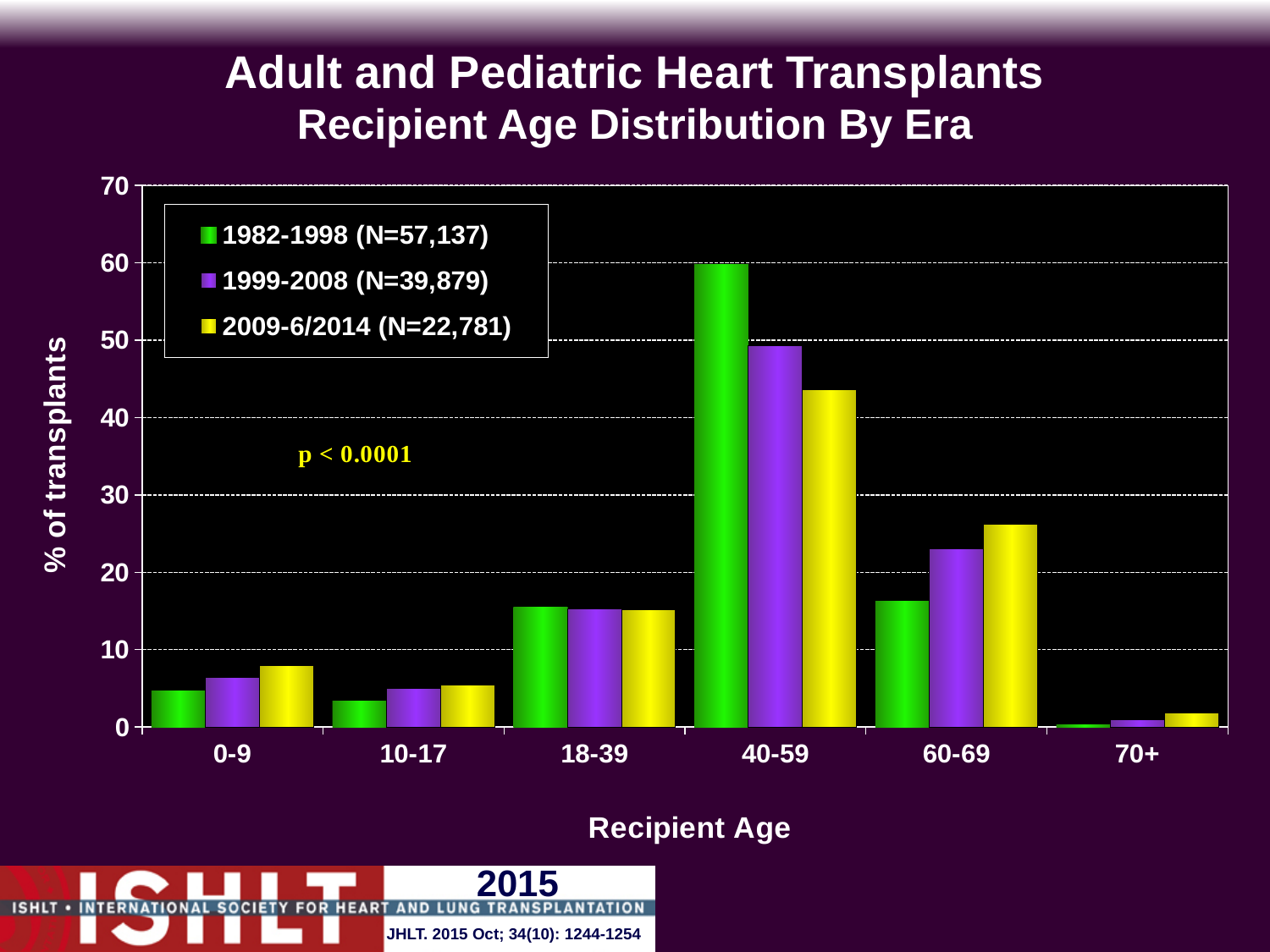
In the 60-69 age group, which era has the larger value: 1982-1998 or 2009-6/2014? 2009-6/2014 Is the value for the 2009-6/2014 era in the 40-59 age group greater or less than 50? less How many recipient age groups are shown on the x axis? 6 What kind of chart is shown on the slide? bar chart Is the value for the 1999-2008 era in the 60-69 age group greater or less than 20? greater Which recipient age group has the highest value for the 1982-1998 era? 40-59 Which recipient age group has the lowest value for the 2009-6/2014 era? 70+ What is the N shown in the legend for the 1999-2008 era? N=39,879 Is the value for the 2009-6/2014 era in the 0-9 age group greater or less than 10? less How many series does the legend list? 3 In the 40-59 age group, which era has the larger value: 1982-1998 or 1999-2008? 1982-1998